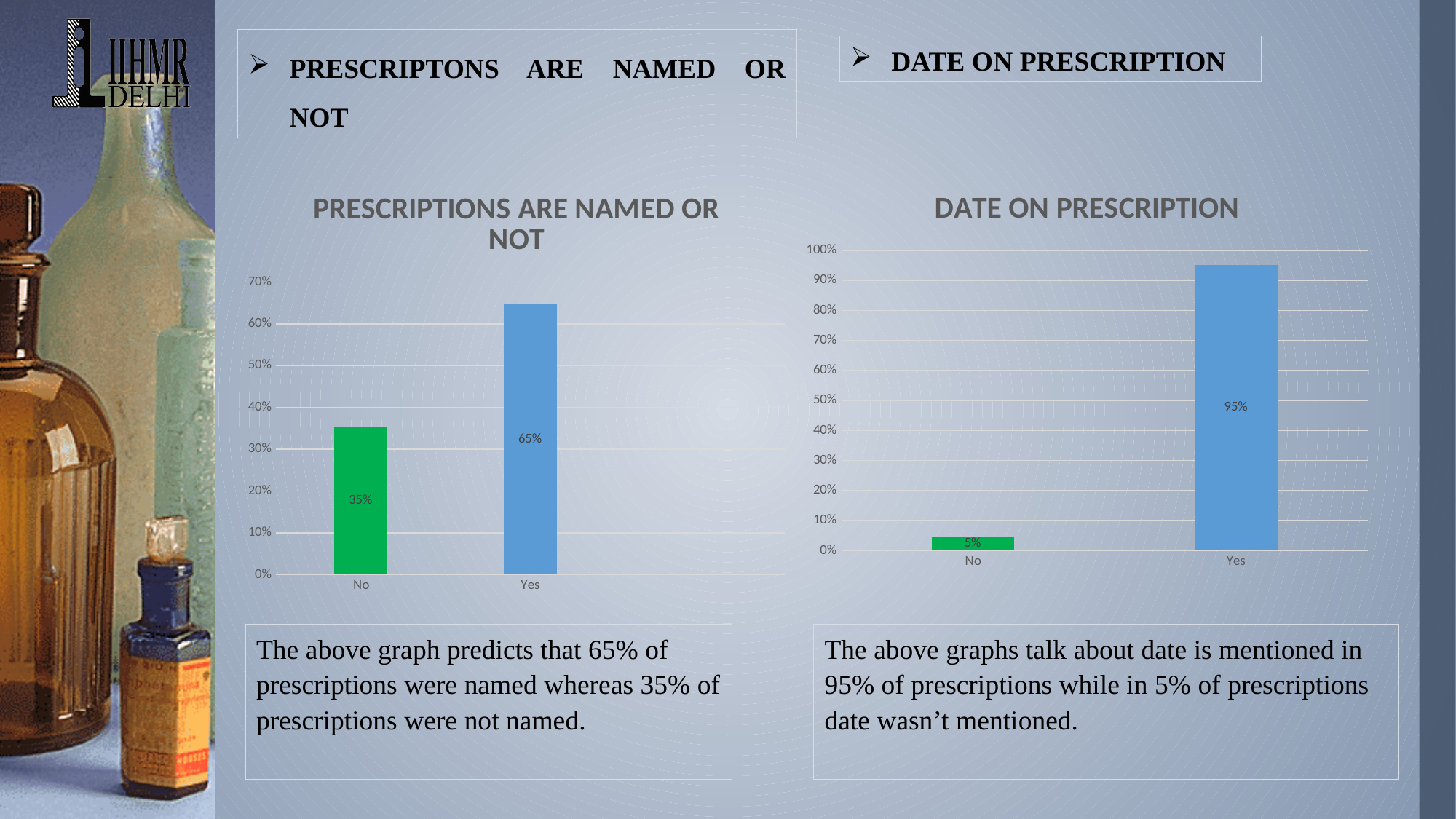
In the 'DATE ON PRESCRIPTION' chart, is the value for 'Yes' greater or less than 90%? greater What type of chart is the 'DATE ON PRESCRIPTION' chart? Bar chart In the 'PRESCRIPTIONS ARE NAMED OR NOT' chart, what is the difference between the 'Yes' and 'No' values? 30% In the 'DATE ON PRESCRIPTION' chart, what is the difference between the 'Yes' and 'No' values? 90% In the 'PRESCRIPTIONS ARE NAMED OR NOT' chart, what is the value for 'No'? 35% In the 'DATE ON PRESCRIPTION' chart, what is the value for 'No'? 5% In the 'PRESCRIPTIONS ARE NAMED OR NOT' chart, which category has the highest value? Yes In the 'DATE ON PRESCRIPTION' chart, which category has the lowest value? No In the 'PRESCRIPTIONS ARE NAMED OR NOT' chart, what is the value for 'Yes'? 65% In the 'PRESCRIPTIONS ARE NAMED OR NOT' chart, what colour is the 'No' bar? Green In the 'DATE ON PRESCRIPTION' chart, what is the value for 'Yes'? 95% How many categories are shown in the 'PRESCRIPTIONS ARE NAMED OR NOT' chart? 2